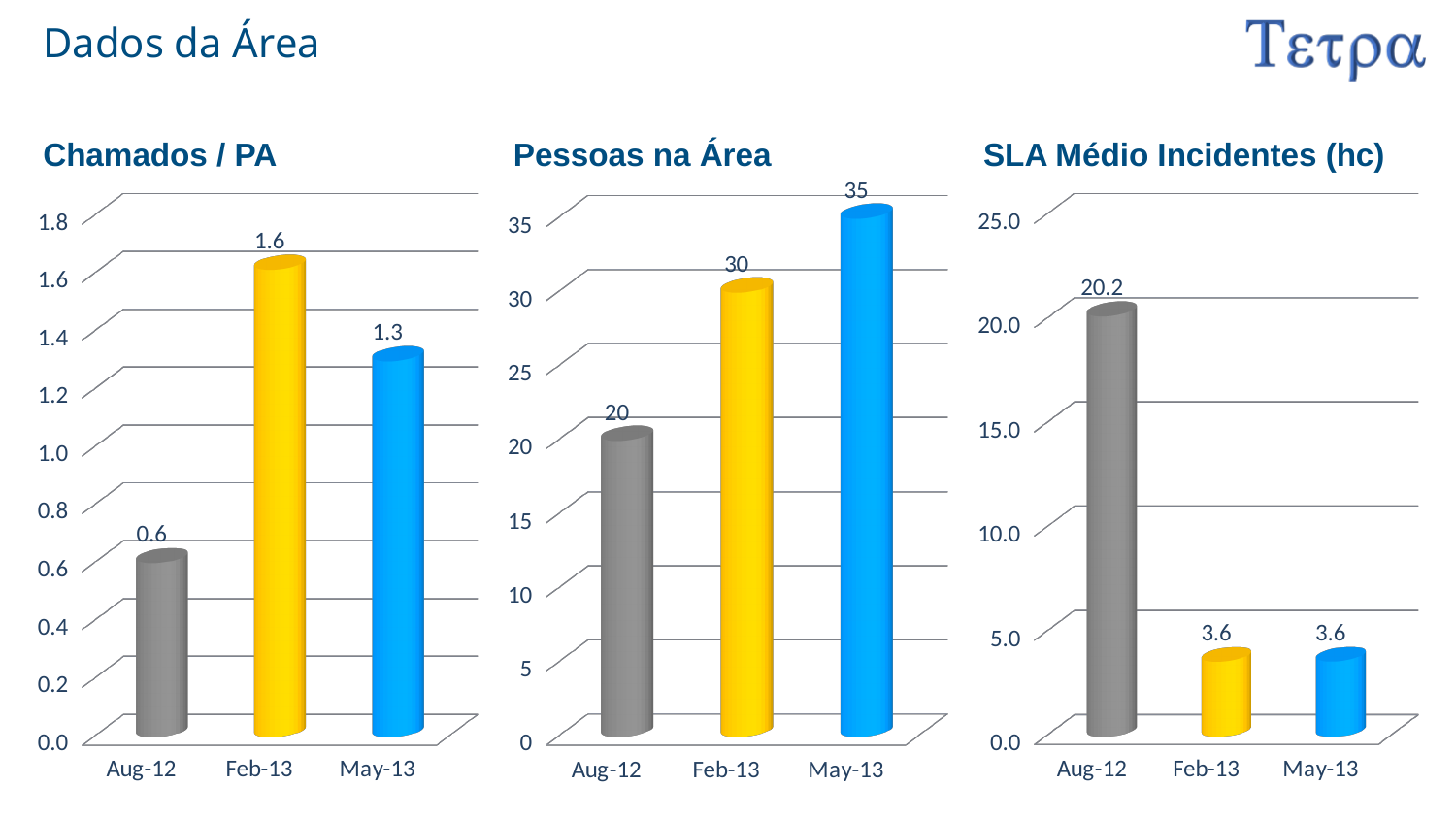
What kind of chart is the 'Pessoas na Área' chart? bar chart In the 'SLA Médio Incidentes (hc)' chart, is the value for Feb-13 greater or less than 5.0? less In the 'Pessoas na Área' chart, what is the difference between the May-13 and Aug-12 values? 15 In the 'Pessoas na Área' chart, do the values rise or fall from Aug-12 to May-13? rise In the 'SLA Médio Incidentes (hc)' chart, which is larger, the value for Aug-12 or the value for May-13? Aug-12 In the 'Pessoas na Área' chart, what is the value for May-13? 35 In the 'SLA Médio Incidentes (hc)' chart, which category has the highest value? Aug-12 In the 'Chamados / PA' chart, what is the value for Feb-13? 1.6 In the 'Chamados / PA' chart, what is the difference between the Feb-13 and May-13 values? 0.3 In the 'Chamados / PA' chart, which category has the lowest value? Aug-12 In the 'SLA Médio Incidentes (hc)' chart, what is the value for Aug-12? 20.2 How many categories are shown on the x axis of the 'Chamados / PA' chart? 3